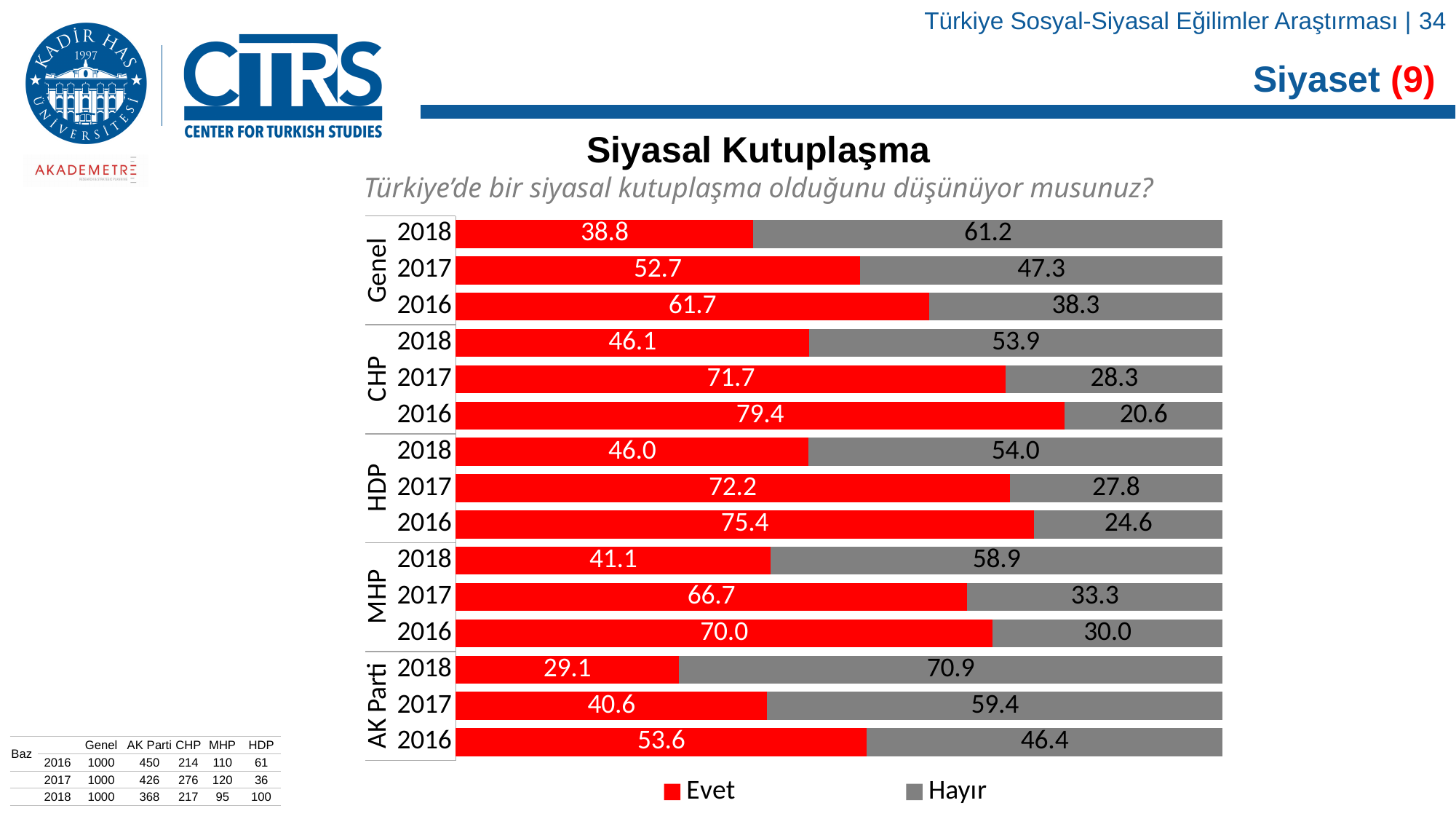
Which is larger, the Evet value for HDP in 2017 or the Evet value for CHP in 2017? HDP 2017 Which colour represents Hayır in the chart? Grey What is the difference between the Evet values for MHP in 2016 and 2018? 28.9 What is the Evet value for AK Parti in 2017? 40.6 What is the Evet value for Genel in 2018? 38.8 Which group and year has the highest Evet value? CHP 2016 How does the Evet value for Genel change from 2016 to 2018? It falls Which group and year has the lowest Evet value? AK Parti 2018 How many series does the legend list? 2 What is the total of the stacked bar for HDP in 2018? 100.0 What kind of chart is shown on the slide? Stacked bar chart What is the Hayır value for CHP in 2016? 20.6